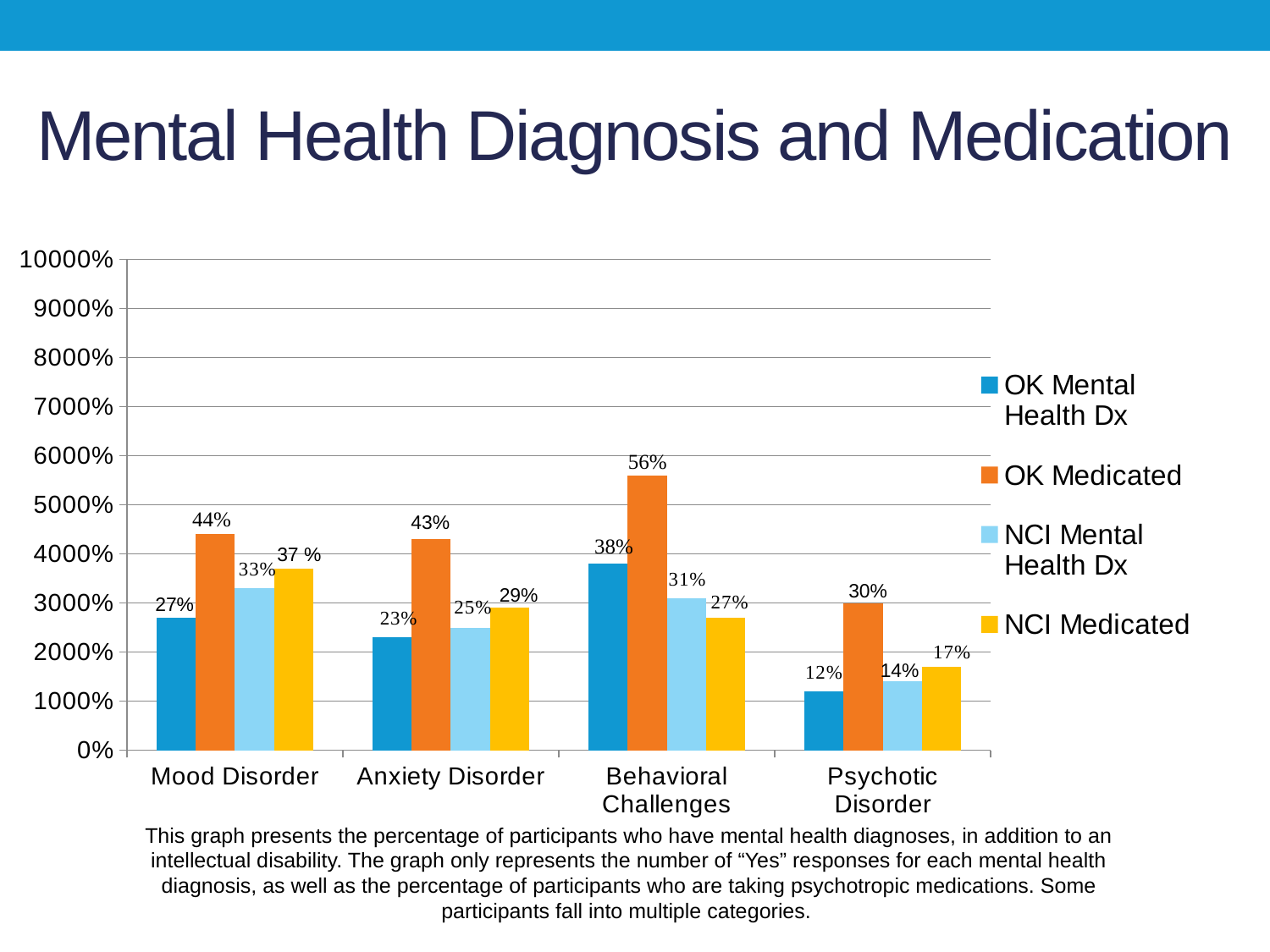
How many diagnosis categories are shown on the x axis? 4 Which colour represents the NCI Medicated series? Yellow What is the OK Mental Health Dx value for Psychotic Disorder? 12% How many series does the legend list? 4 Which category has the lowest NCI Mental Health Dx value? Psychotic Disorder What kind of chart is shown on the slide? Bar chart What is the OK Medicated value for Behavioral Challenges? 56% What is the NCI Mental Health Dx value for Anxiety Disorder? 25% For Anxiety Disorder, which is larger: OK Medicated or NCI Medicated? OK Medicated What is the difference between the OK Medicated and OK Mental Health Dx values for Mood Disorder? 17% Which category has the highest OK Medicated value? Behavioral Challenges What is the NCI Medicated value for Mood Disorder? 37 %